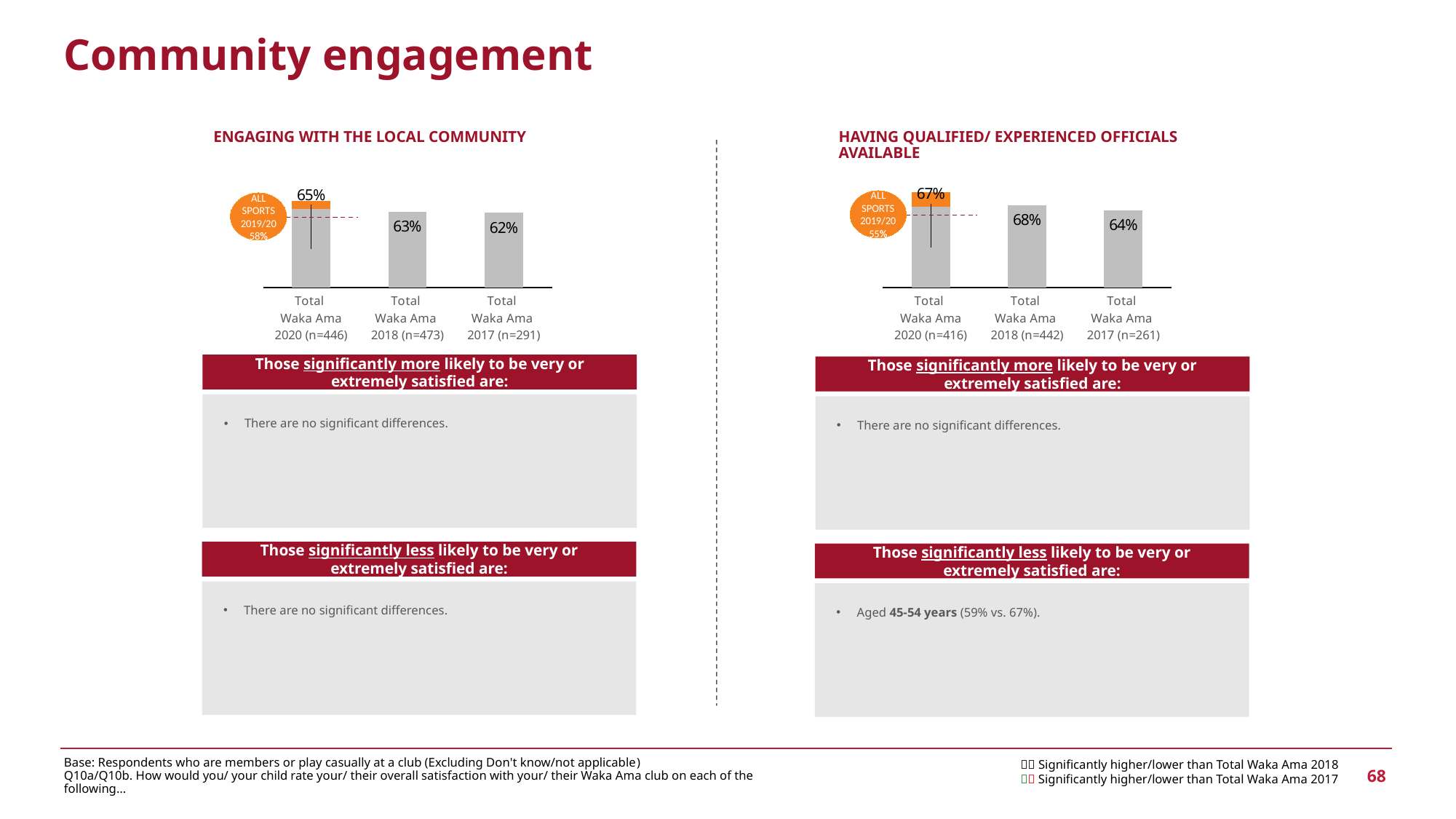
In the 'Engaging with the local community' chart, which category has the highest value? Total Waka Ama 2020 In the 'Having qualified/ experienced officials available' chart, what is the value for Total Waka Ama 2020? 67% In the 'Having qualified/ experienced officials available' chart, what is the difference between Total Waka Ama 2018 and Total Waka Ama 2017? 4% In the 'Engaging with the local community' chart, what is the difference between Total Waka Ama 2020 and Total Waka Ama 2018? 2% In the 'Engaging with the local community' chart, how many bars are plotted? 3 In the 'Having qualified/ experienced officials available' chart, which is larger: Total Waka Ama 2020 or Total Waka Ama 2017? Total Waka Ama 2020 What kind of chart is used in the 'Engaging with the local community' section? Bar chart In the 'Engaging with the local community' chart, what is the value for Total Waka Ama 2017? 62% In the 'Having qualified/ experienced officials available' chart, which category has the lowest value? Total Waka Ama 2017 In the 'Having qualified/ experienced officials available' chart, what is the All Sports 2019/20 benchmark value shown in the orange circle? 55% In the 'Engaging with the local community' chart, what is the value for Total Waka Ama 2020? 65% In the 'Having qualified/ experienced officials available' chart, what is the value for Total Waka Ama 2018? 68%